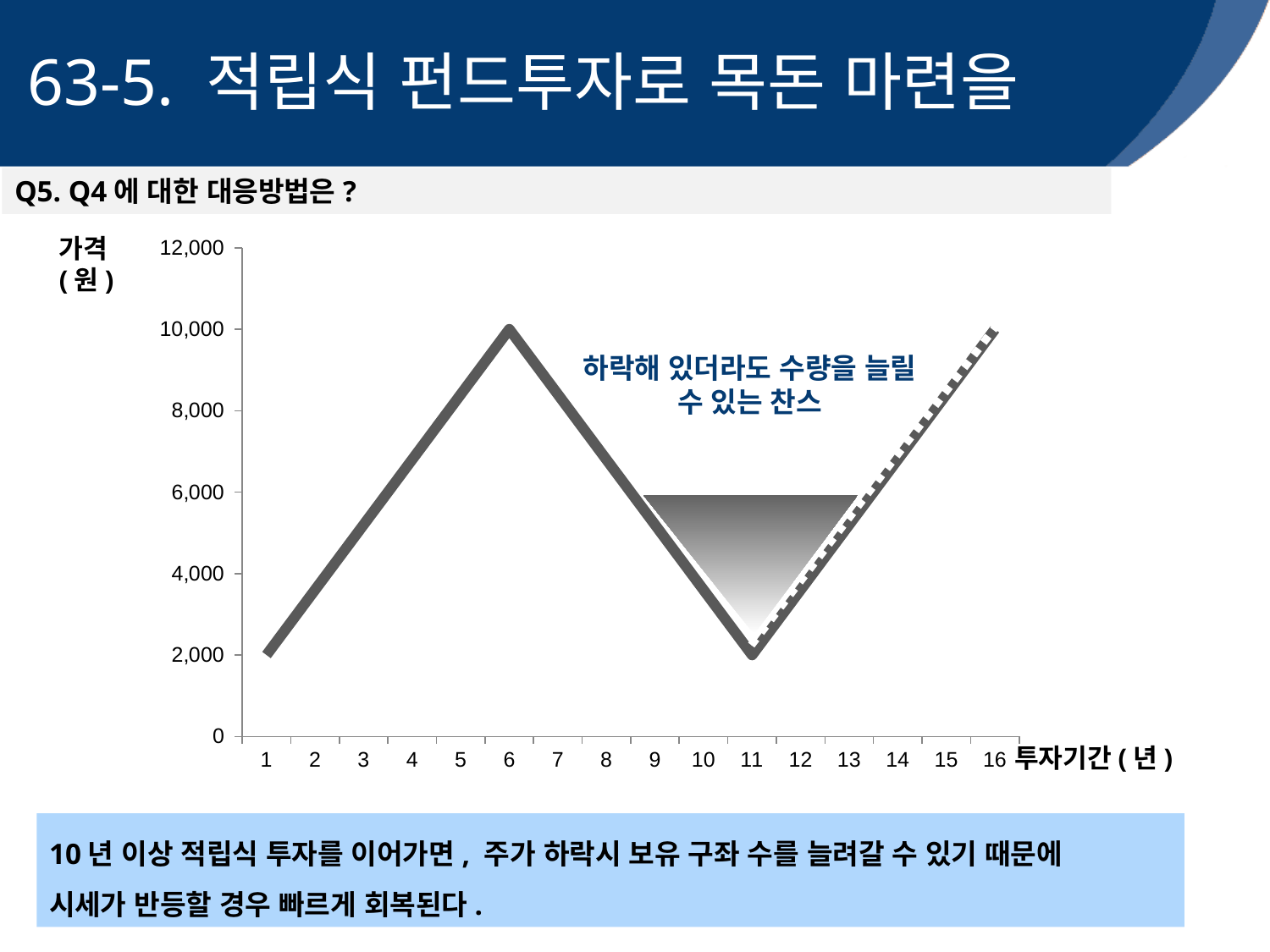
What is the label of the y axis? 가격 (원) Is the price at year 8 greater or less than 8,000? less How many investment-period points (years) are marked along the x axis? 16 Is the price at year 3 greater or less than 4,000? greater What is the price (원) at year 1? 2,000 What is the price (원) at year 11? 2,000 Does the price rise or fall between year 6 and year 11? fall What is the price (원) at year 6? 10,000 What is the label of the x axis? 투자기간 (년) Which is larger, the price at year 6 or the price at year 11? year 6 What kind of chart is shown on the slide? line chart What is the difference between the price at year 6 and the price at year 11? 8,000